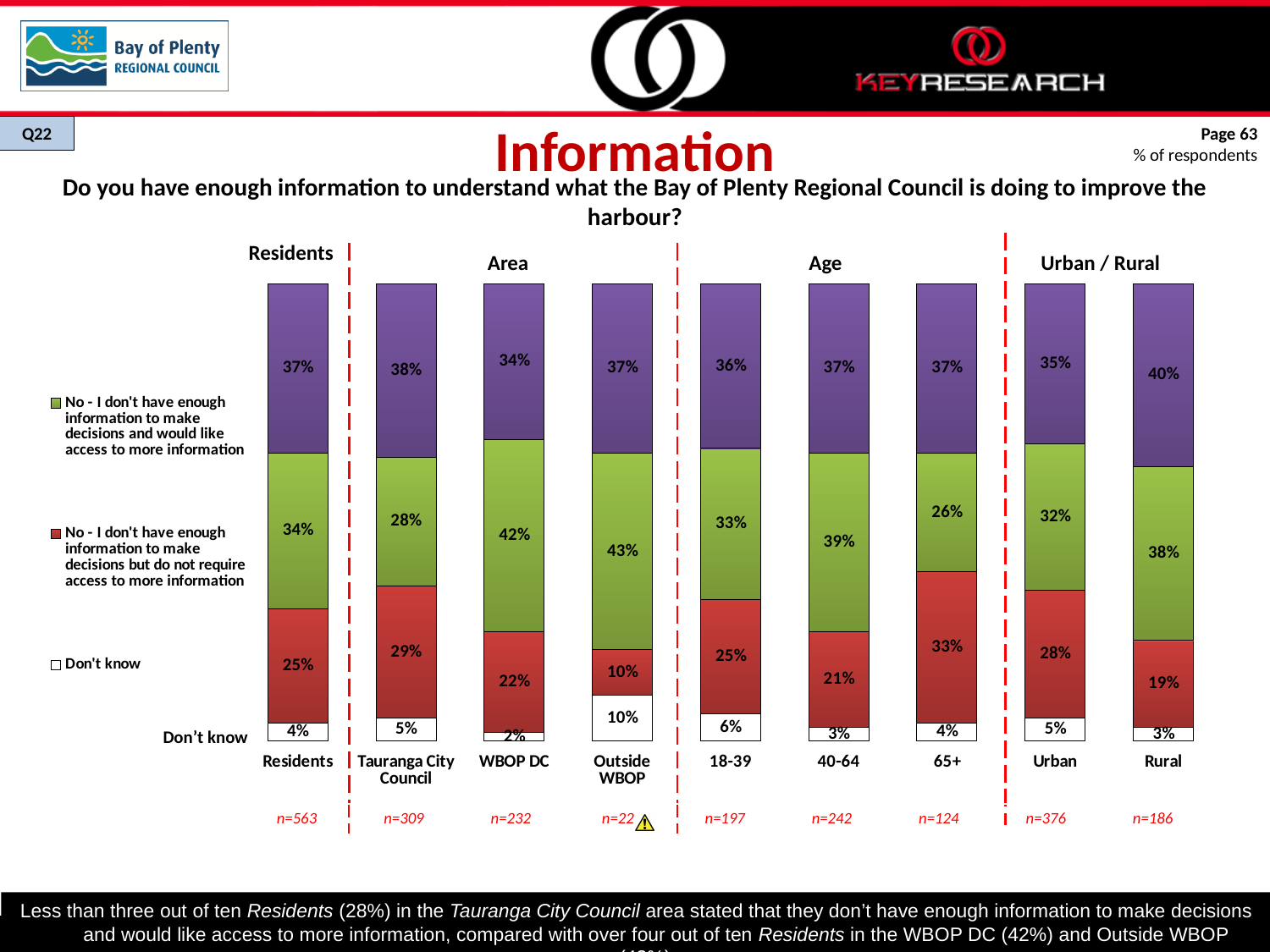
Which category has the highest share of respondents who don't have enough information and would like access to more information? Outside WBOP How many categories (bars) are shown on the chart? 9 What is the value of the top (purple) segment for the Rural bar? 40% What is the difference in percentage points between WBOP DC and Tauranga City Council for respondents who would like access to more information? 14 percentage points Which has a larger share of respondents who don't have enough information but do not require more: Residents or Tauranga City Council? Tauranga City Council What type of chart is shown on the slide? Stacked bar chart What is the sample size (n) shown for the Rural category? n=186 What is the total of the stacked bar for Residents? 100% What percentage of WBOP DC respondents said they don't have enough information to make decisions and would like access to more information? 42% What percentage of Residents answered "Don't know"? 4% What percentage of 65+ respondents said they don't have enough information to make decisions but do not require access to more information? 33% Which category has the lowest "Don't know" percentage? WBOP DC